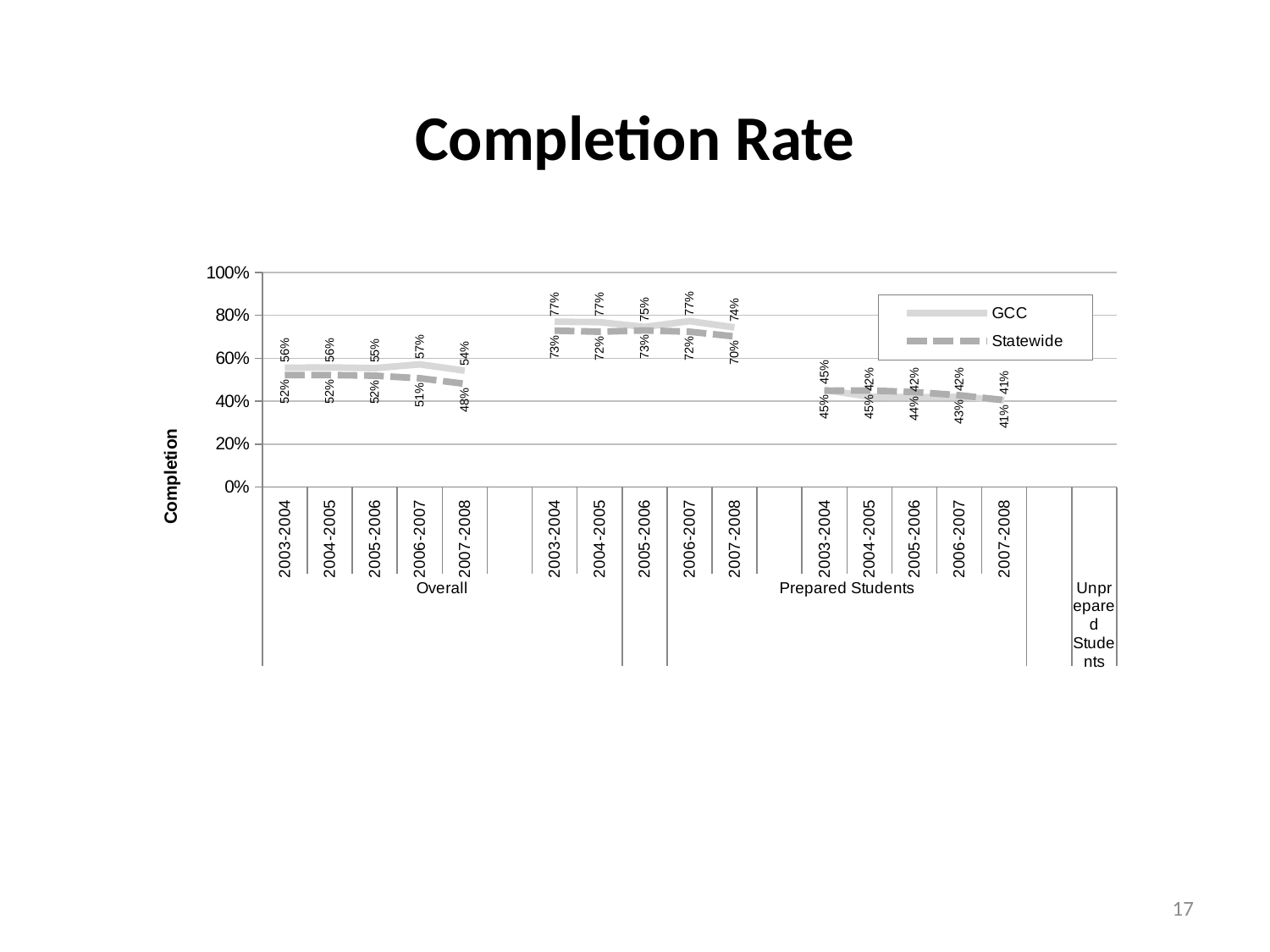
In the Overall group, which year has the lowest Statewide completion rate? 2007-2008 In the Overall group, what is the Statewide completion rate for 2007-2008? 48% In the Overall group, what is the GCC completion rate for 2006-2007? 57% In the middle group of years (values in the 70s), what is the GCC completion rate for 2007-2008? 74% In the Overall group, does the Statewide completion rate rise or fall from 2003-2004 to 2007-2008? Fall In the right-hand group of years (values in the 40s), what is the completion rate shown for 2007-2008? 41% What kind of chart is shown on the slide? Line chart In the Overall group, which year has the highest GCC completion rate? 2006-2007 How many series does the legend list? 2 In the middle group of years (values in the 70s), which is larger for 2005-2006, GCC or Statewide? GCC What are the two series named in the legend? GCC and Statewide In the Overall group, what is the difference between the GCC and Statewide completion rates for 2007-2008? 6 percentage points